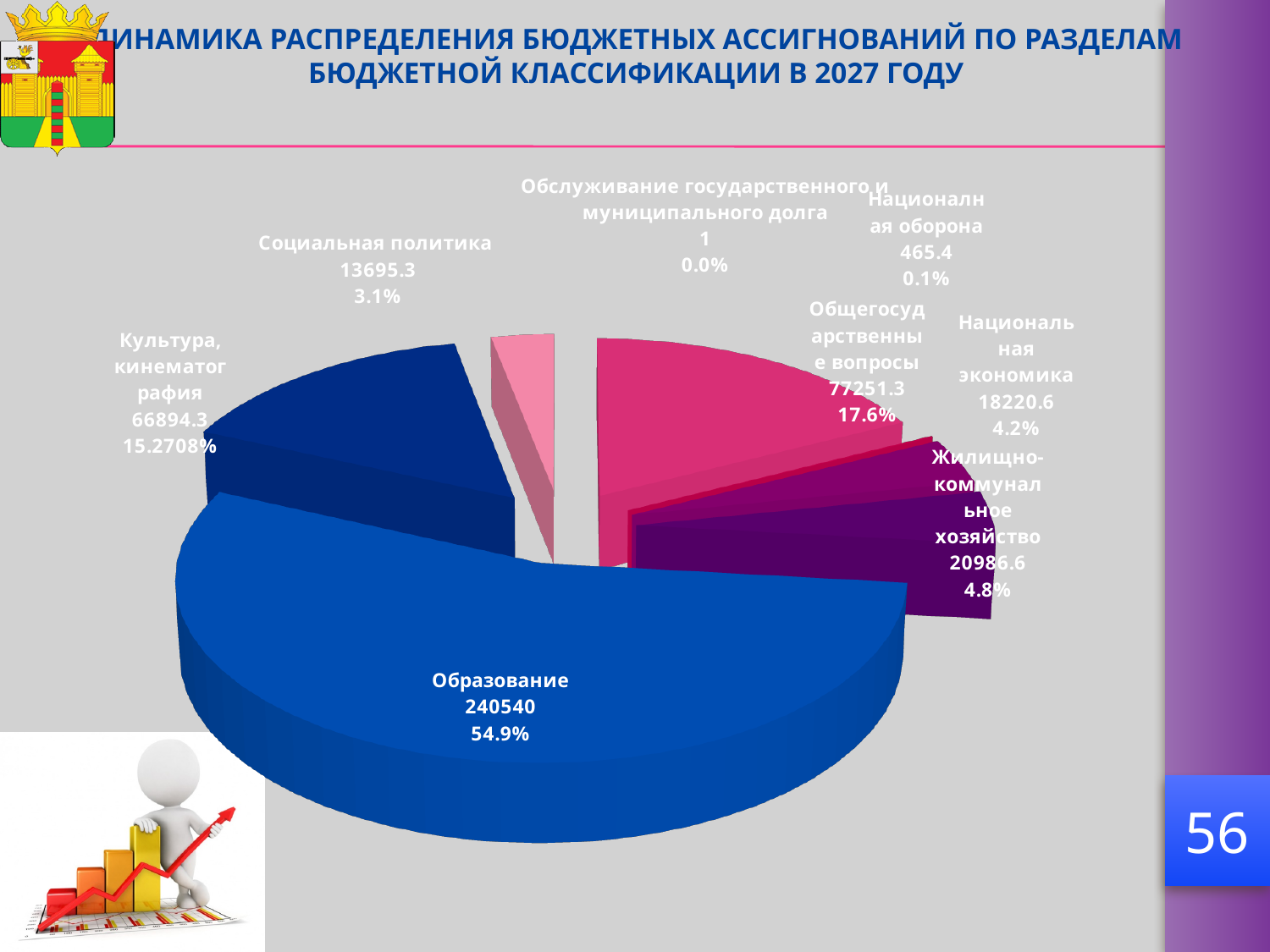
Which is larger: the value for Социальная политика or the value for Национальная оборона? Социальная политика What is the value shown for Общегосударственные вопросы? 77251.3 What is the value shown for Образование? 240540 What kind of chart is shown on the slide? Pie chart What percentage is shown for Культура, кинематография? 15.2708% Which category has the largest share of the pie? Образование What is the value shown for Жилищно-коммунальное хозяйство? 20986.6 What percentage is shown for Национальная экономика? 4.2% What is the difference between the values for Жилищно-коммунальное хозяйство and Национальная экономика? 2766 Which category has the smallest value in the pie chart? Обслуживание государственного и муниципального долга How many categories (slices) does the pie chart show? 8 What share of the pie does Образование represent? 54.9%